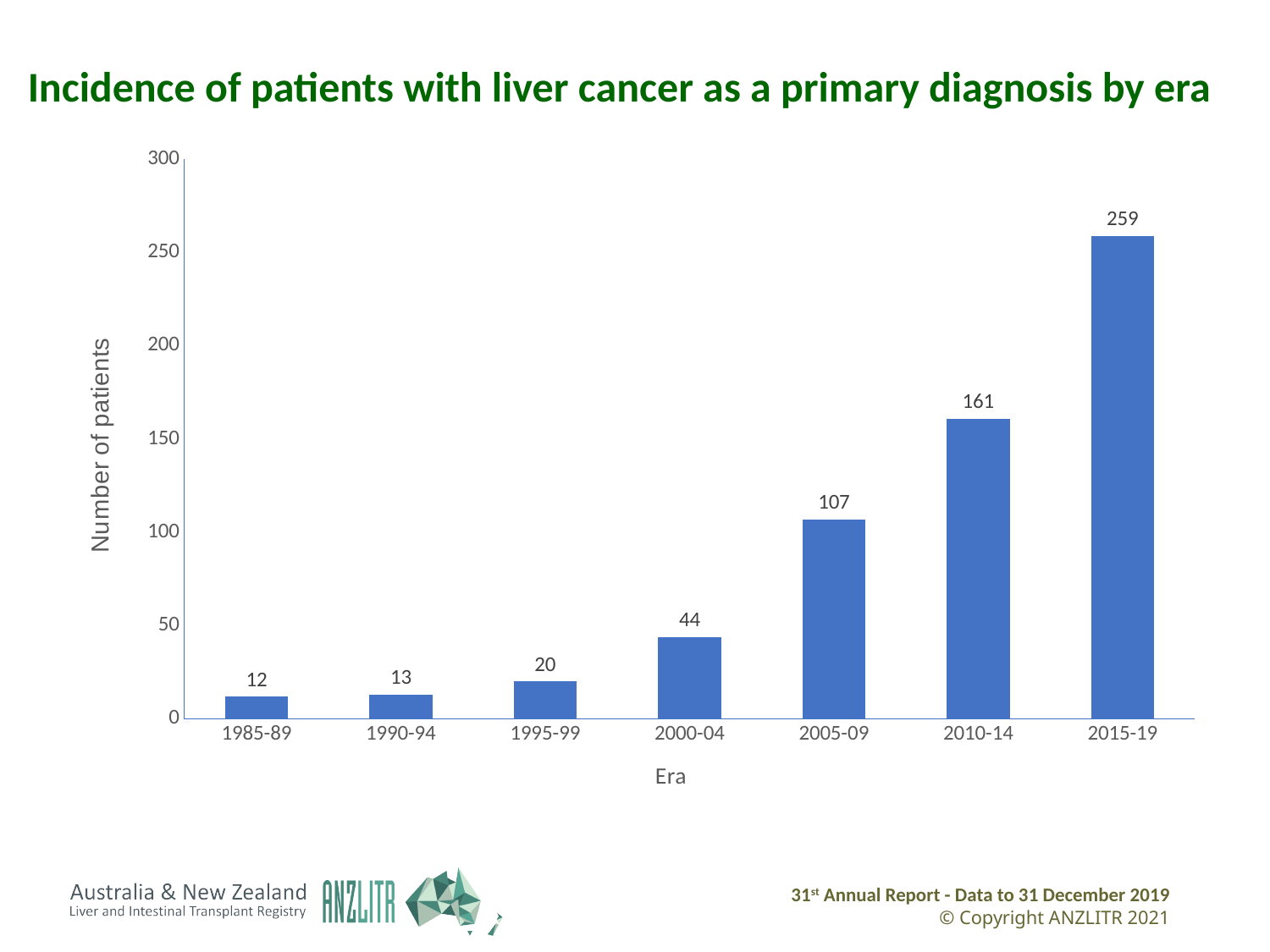
Which era has more patients, 2005-09 or 2010-14? 2010-14 What is the number of patients for the 2000-04 era? 44 Which era has the lowest number of patients? 1985-89 What is the number of patients for the 1995-99 era? 20 What is the difference in number of patients between the 2005-09 and 2000-04 eras? 63 Do the values rise or fall from the 1985-89 era to the 2015-19 era? Rise Which era has the highest number of patients? 2015-19 What is the number of patients for the 2015-19 era? 259 How many eras are shown on the x axis? 7 What is the difference in number of patients between the 2015-19 and 2010-14 eras? 98 What kind of chart is shown on the slide? Bar chart Is the value for 2010-14 greater or less than 150? greater